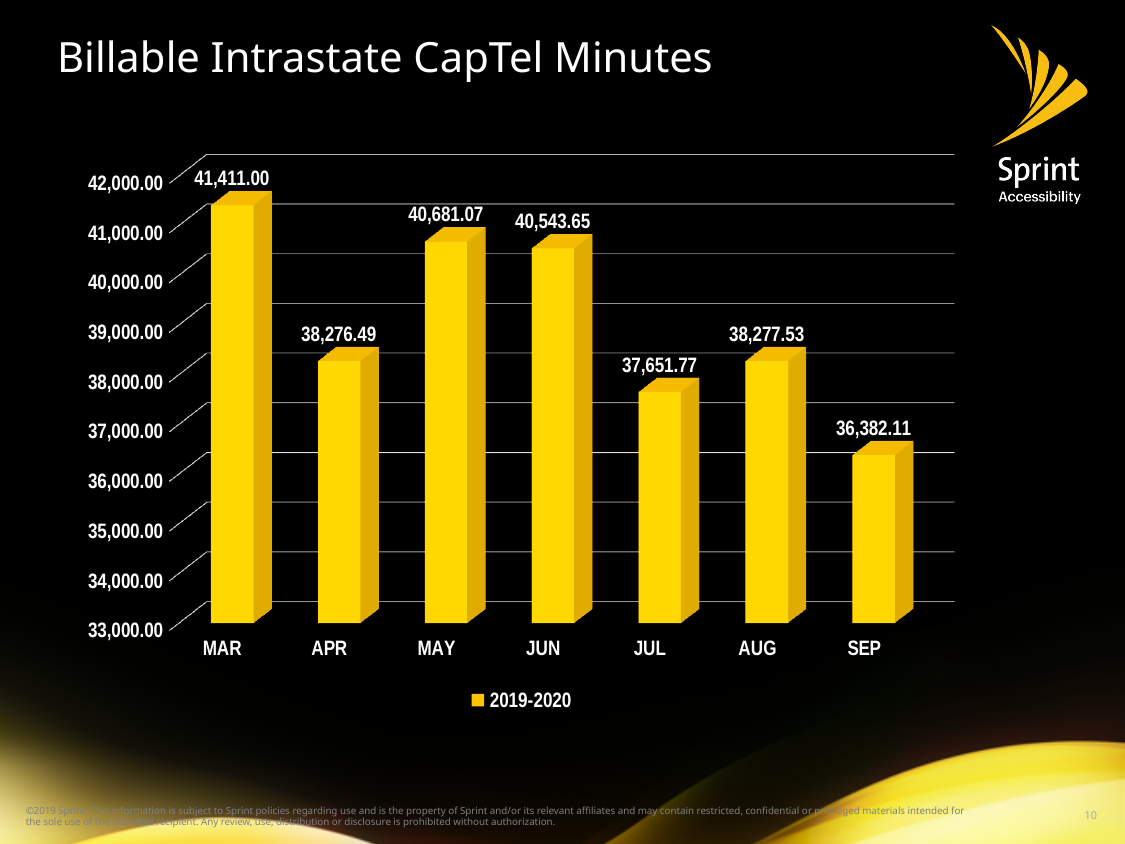
Which is larger, the value for MAY or the value for JUL? MAY What kind of chart is shown? bar chart What series does the legend list? 2019-2020 Which month has the lowest value? SEP What is the difference between the values for MAR and SEP? 5,028.89 What is the value for SEP? 36,382.11 What is the difference between the values for MAY and JUN? 137.42 Which month has the highest value? MAR What is the value for JUL? 37,651.77 How many months are shown on the x axis? 7 Is the value for JUN greater or less than 40,000.00? greater What is the value for MAR? 41,411.00